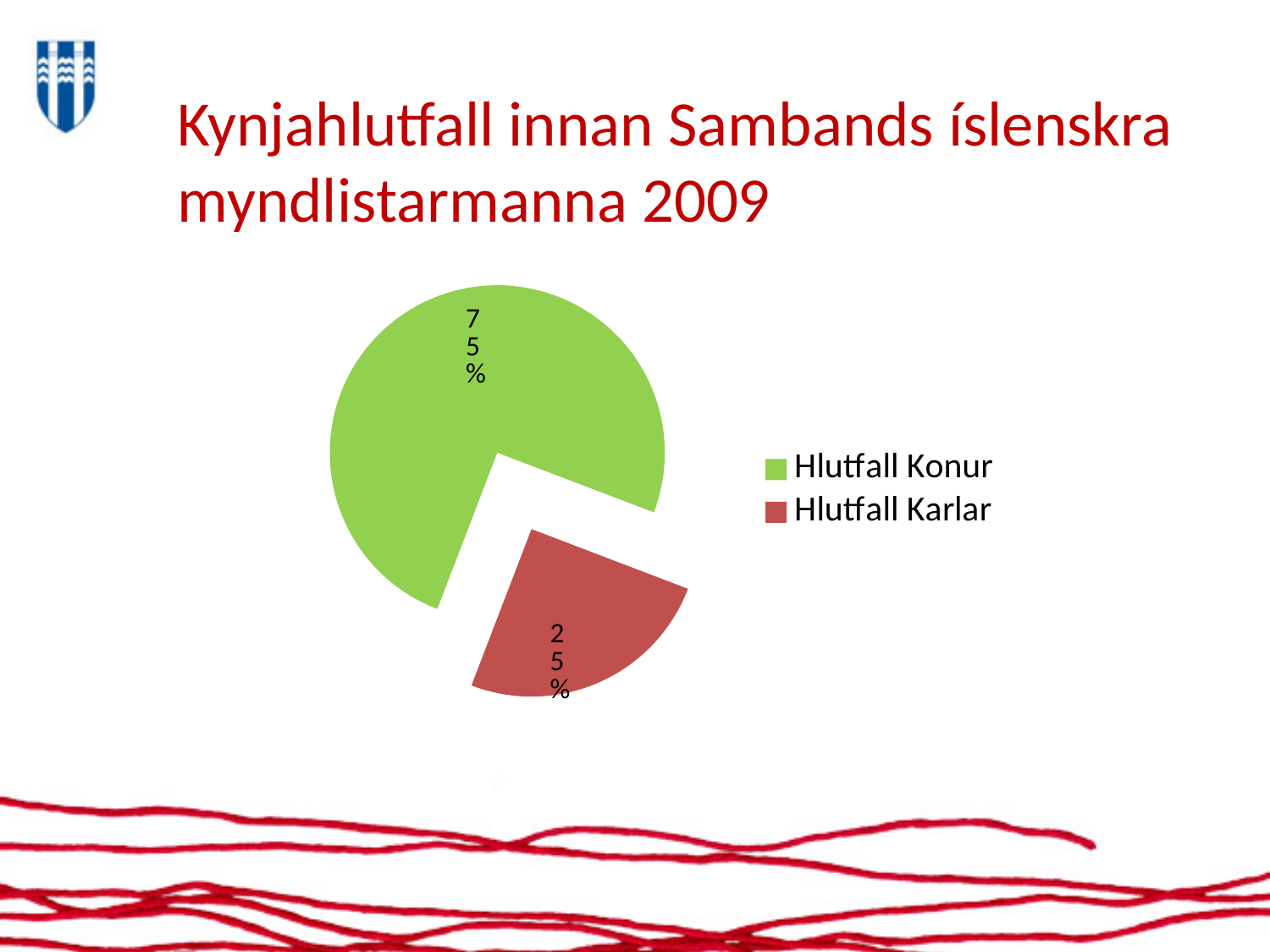
How many entries does the legend list? 2 What kind of chart is shown on the slide? pie chart Which slice of the pie is the largest? Hlutfall Konur What is the difference in percentage points between Hlutfall Konur and Hlutfall Karlar? 50 What colour is the Hlutfall Karlar slice? red What share of the pie does Hlutfall Karlar represent? 25% What is the title of the slide containing the pie chart? Kynjahlutfall innan Sambands íslenskra myndlistarmanna 2009 How many slices does the pie chart have? 2 What share of the pie does Hlutfall Konur represent? 75% Which slice of the pie is the smallest? Hlutfall Karlar Which is larger, Hlutfall Konur or Hlutfall Karlar? Hlutfall Konur